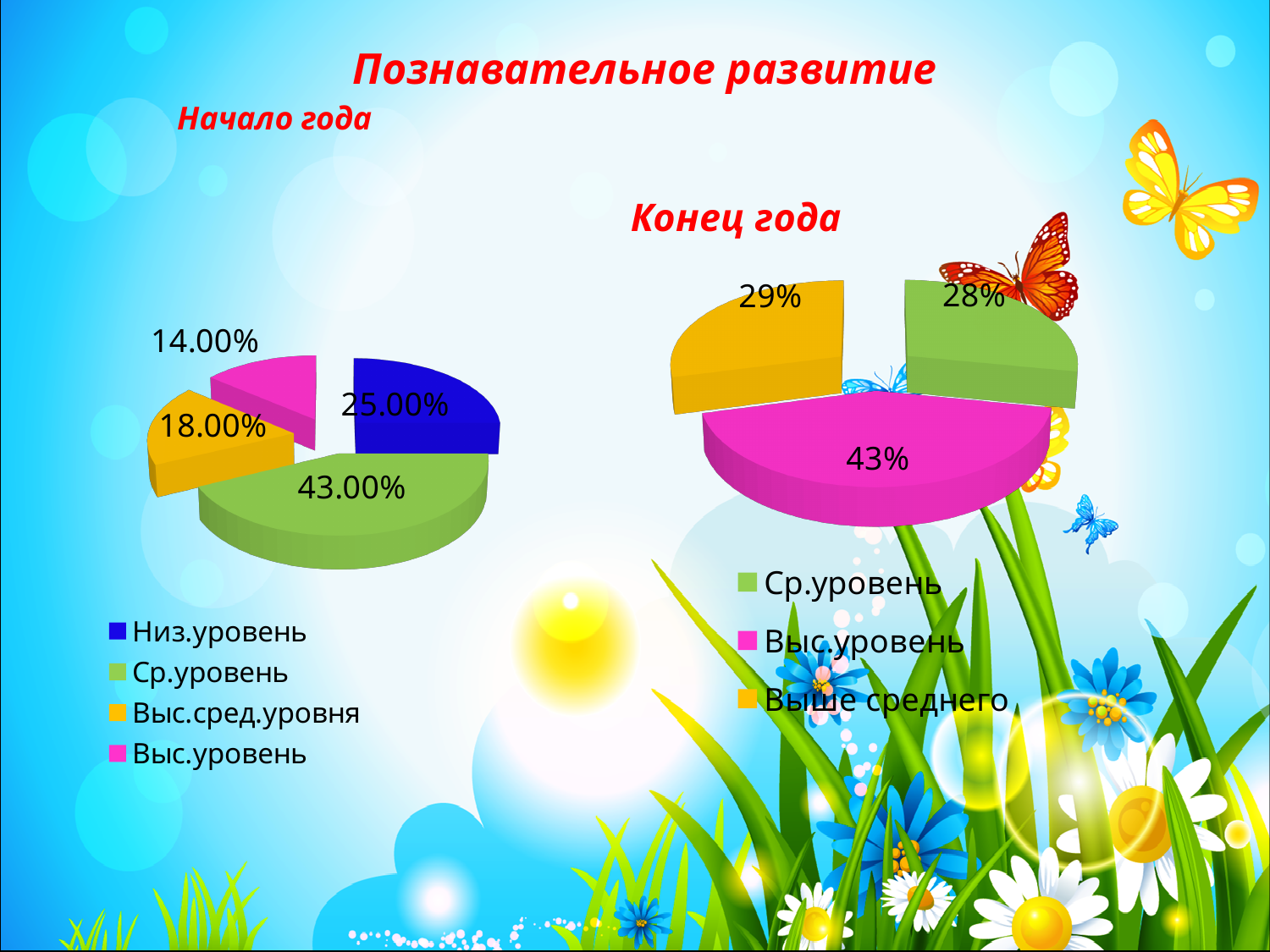
In the "Начало года" chart, which category has the smallest share? Выс.уровень In the "Начало года" chart, which category has the largest share? Ср.уровень In the "Конец года" chart, what is the value for Выс.уровень? 43% What type of chart is the "Конец года" chart? Pie chart In the "Конец года" chart, what is the value for Выше среднего? 29% In the "Конец года" chart, which category has the smallest share? Ср.уровень In the "Начало года" chart, what is the difference between Низ.уровень and Выс.уровень? 11.00% In the "Начало года" chart, how many categories does the legend list? 4 In the "Начало года" chart, what is the value for Низ.уровень? 25.00% In the "Начало года" chart, what is the value for Выс.сред.уровня? 18.00% In the "Конец года" chart, how many categories does the legend list? 3 In the "Начало года" chart, what is the value for Ср.уровень? 43.00%